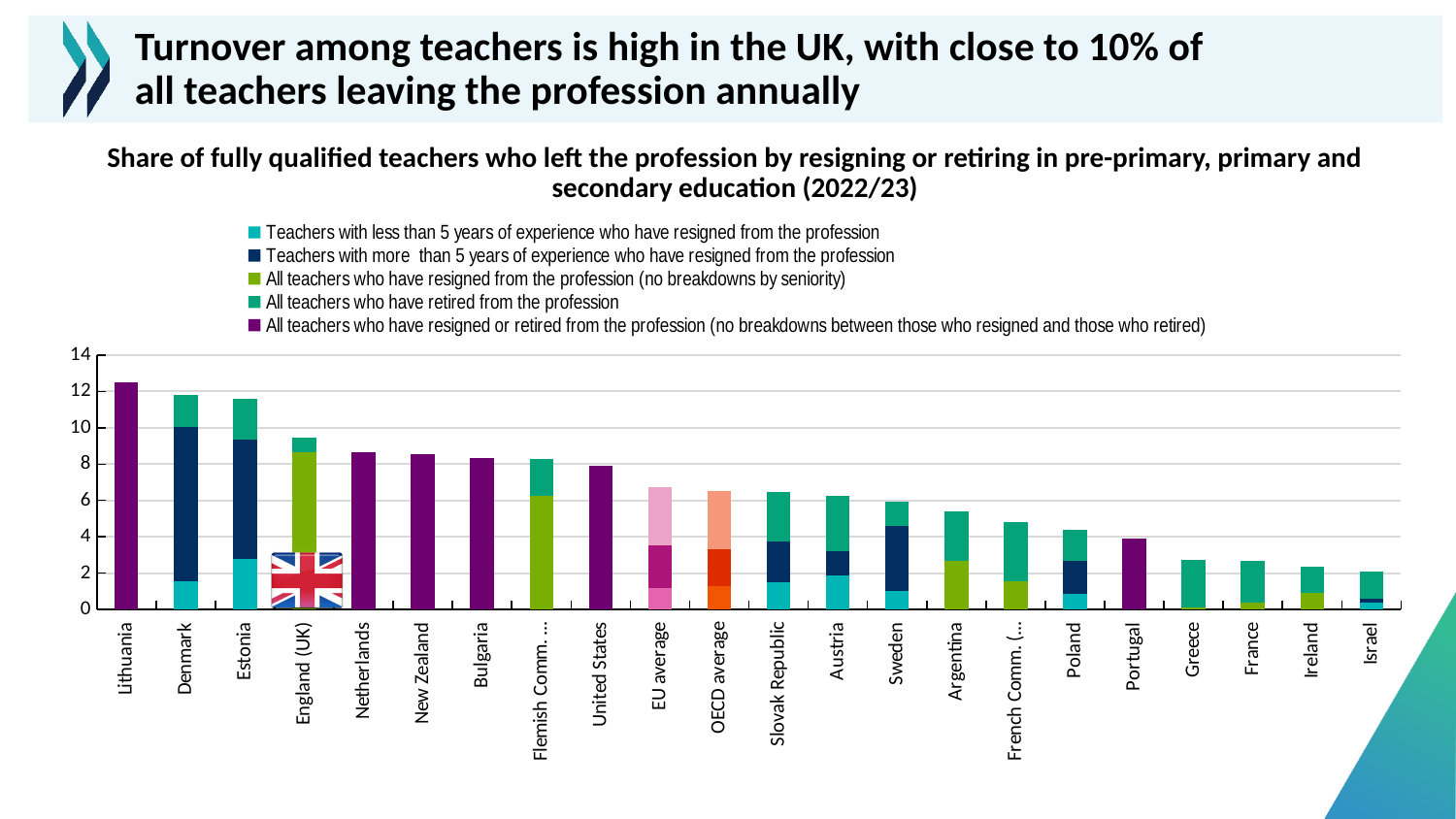
Which has a larger total value, Denmark or Greece? Denmark Is the total value for Lithuania greater or less than 12? greater What kind of chart is shown on the slide? Stacked bar chart How many series does the legend list? 5 Is the total value for Argentina greater or less than 6? less How many countries or regions are shown on the x axis? 22 Is the total value for England (UK) greater or less than 8? greater Do the total values rise or fall moving from left to right along the x axis? Fall Which country has the lowest total share of teachers who left the profession? Israel Which country has the highest total share of teachers who left the profession? Lithuania Which legend entry is shown in purple? All teachers who have resigned or retired from the profession (no breakdowns between those who resigned and those who retired)